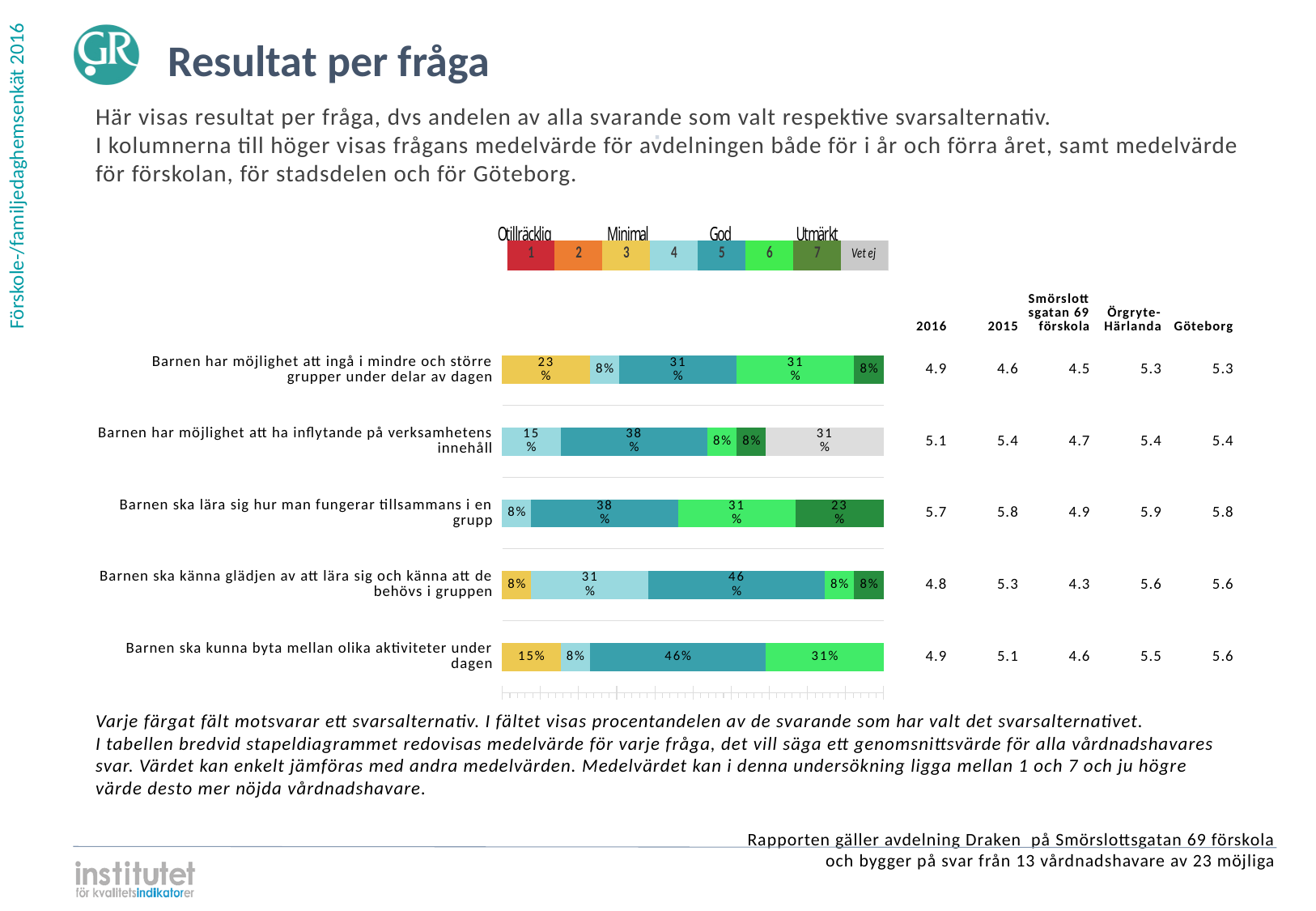
How many questions (categories) are shown in the bar chart? 5 What percentage chose alternative 3 (yellow) for 'Barnen har möjlighet att ingå i mindre och större grupper under delar av dagen'? 23% Which question has the lowest 2016 mean value in the table? Barnen ska känna glädjen av att lära sig och känna att de behövs i gruppen (4.8) What kind of chart is used to show the results per question? Stacked bar chart What is the 2016 mean value for 'Barnen ska lära sig hur man fungerar tillsammans i en grupp'? 5.7 For 'Barnen ska känna glädjen av att lära sig och känna att de behövs i gruppen', what is the difference between the share choosing alternative 5 (46%) and alternative 4 (31%)? 15 percentage points Which question has the largest single segment in its bar? Barnen ska känna glädjen av att lära sig och känna att de behövs i gruppen (46%) and Barnen ska kunna byta mellan olika aktiviteter under dagen (46%) What percentage of respondents chose alternative 5 (God, teal) for 'Barnen ska kunna byta mellan olika aktiviteter under dagen'? 46% What percentage chose alternative 7 (dark green) for 'Barnen ska lära sig hur man fungerar tillsammans i en grupp'? 23% How many answer alternatives does the legend above the chart list? 8 Which is larger for 'Barnen ska lära sig hur man fungerar tillsammans i en grupp': the share choosing alternative 5 or alternative 6? Alternative 5 (38%) What percentage chose 'Vet ej' for 'Barnen har möjlighet att ha inflytande på verksamhetens innehåll'? 31%